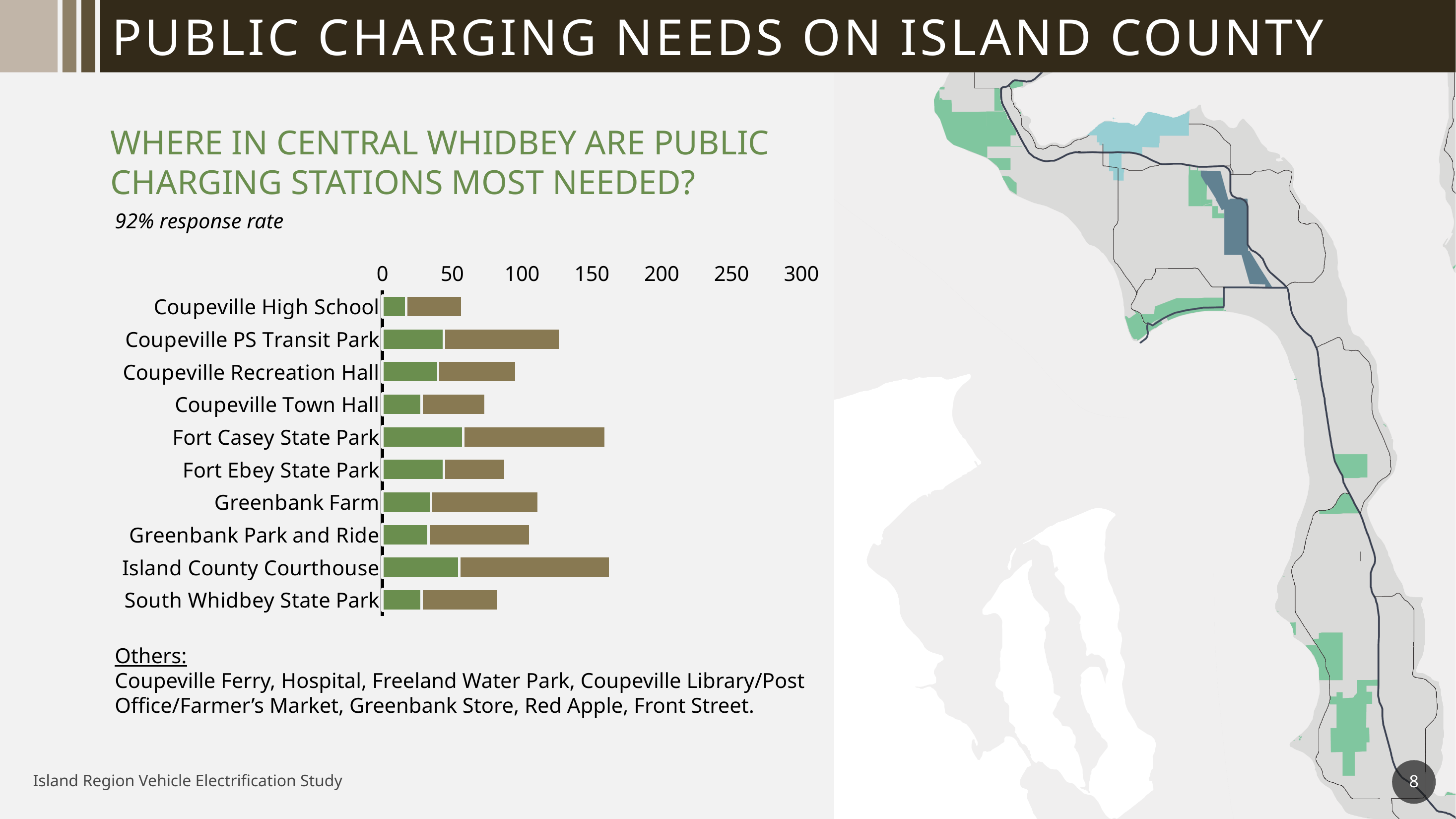
Is the total bar for Island County Courthouse greater or less than 150? greater Is the total bar for Fort Casey State Park greater or less than 150? greater Which has the longer total bar, Fort Casey State Park or Fort Ebey State Park? Fort Casey State Park Is the total bar for Coupeville PS Transit Park greater or less than 100? greater What is the highest value shown on the chart's horizontal axis? 300 What kind of chart is shown on the slide? bar chart Which has the longer total bar, Coupeville PS Transit Park or Coupeville Recreation Hall? Coupeville PS Transit Park Which location has the shortest total bar in the chart? Coupeville High School What response rate is noted above the chart? 92% response rate How many locations are listed as categories in the chart? 10